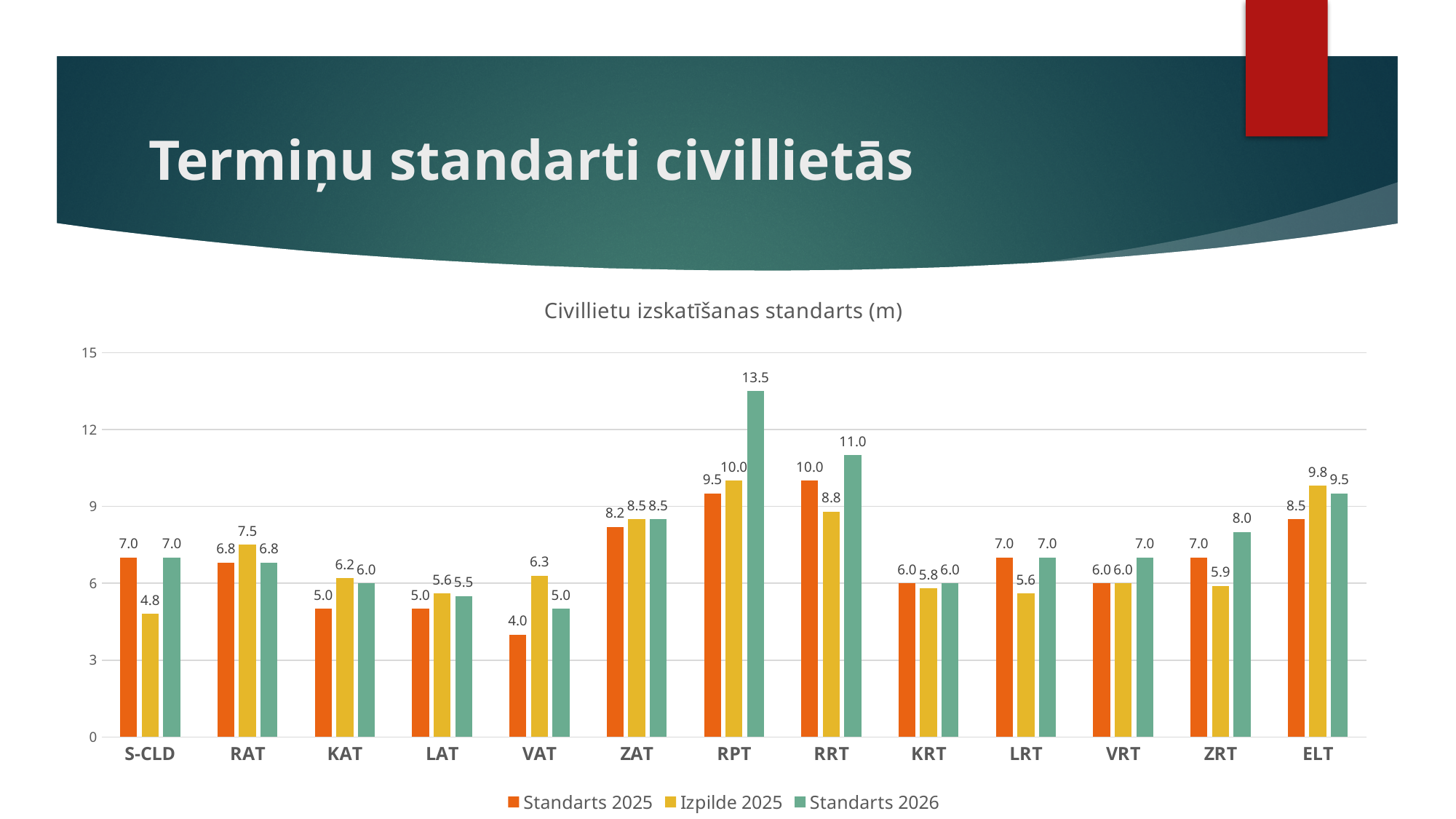
What is the title of the chart? Civillietu izskatīšanas standarts (m) What kind of chart is shown on the slide? bar chart How many categories are shown on the x axis? 13 Which category has the highest Standarts 2026 value? RPT What is the Standarts 2026 value for RPT? 13.5 What is the Izpilde 2025 value for S-CLD? 4.8 Which is larger for RRT: Izpilde 2025 or Standarts 2026? Standarts 2026 What is the difference between the Standarts 2026 and Standarts 2025 values for ZRT? 1.0 What is the Standarts 2025 value for RRT? 10.0 Which category has the lowest Standarts 2025 value? VAT How many series does the legend list? 3 Is the Standarts 2026 value for RPT greater or less than 12? greater